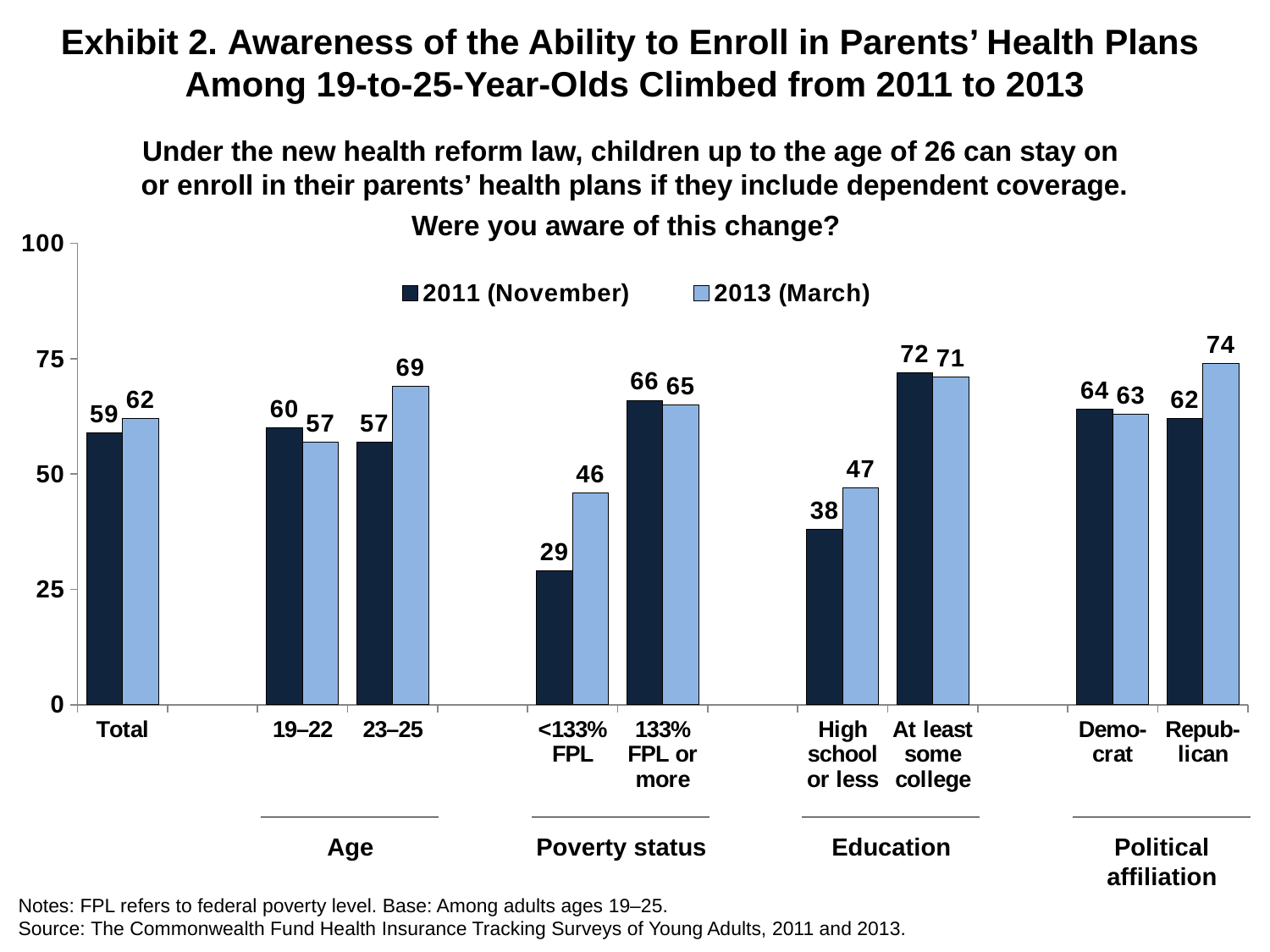
What is the difference between the 2013 (March) and 2011 (November) values for 23–25? 12 Which category has the lowest 2011 (November) value? <133% FPL What is the 2013 (March) value for Total? 62 What kind of chart is shown on the slide? bar chart What is the 2011 (November) value for <133% FPL? 29 How many categories are shown on the x axis? 9 What is the 2013 (March) value for Republican? 74 Which is larger for 19–22: the 2011 (November) value or the 2013 (March) value? 2011 (November) Which category has the highest 2013 (March) value? Republican How many series does the legend list? 2 What is the difference between the 2013 (March) and 2011 (November) values for <133% FPL? 17 Is the 2011 (November) value for High school or less greater or less than 50? less